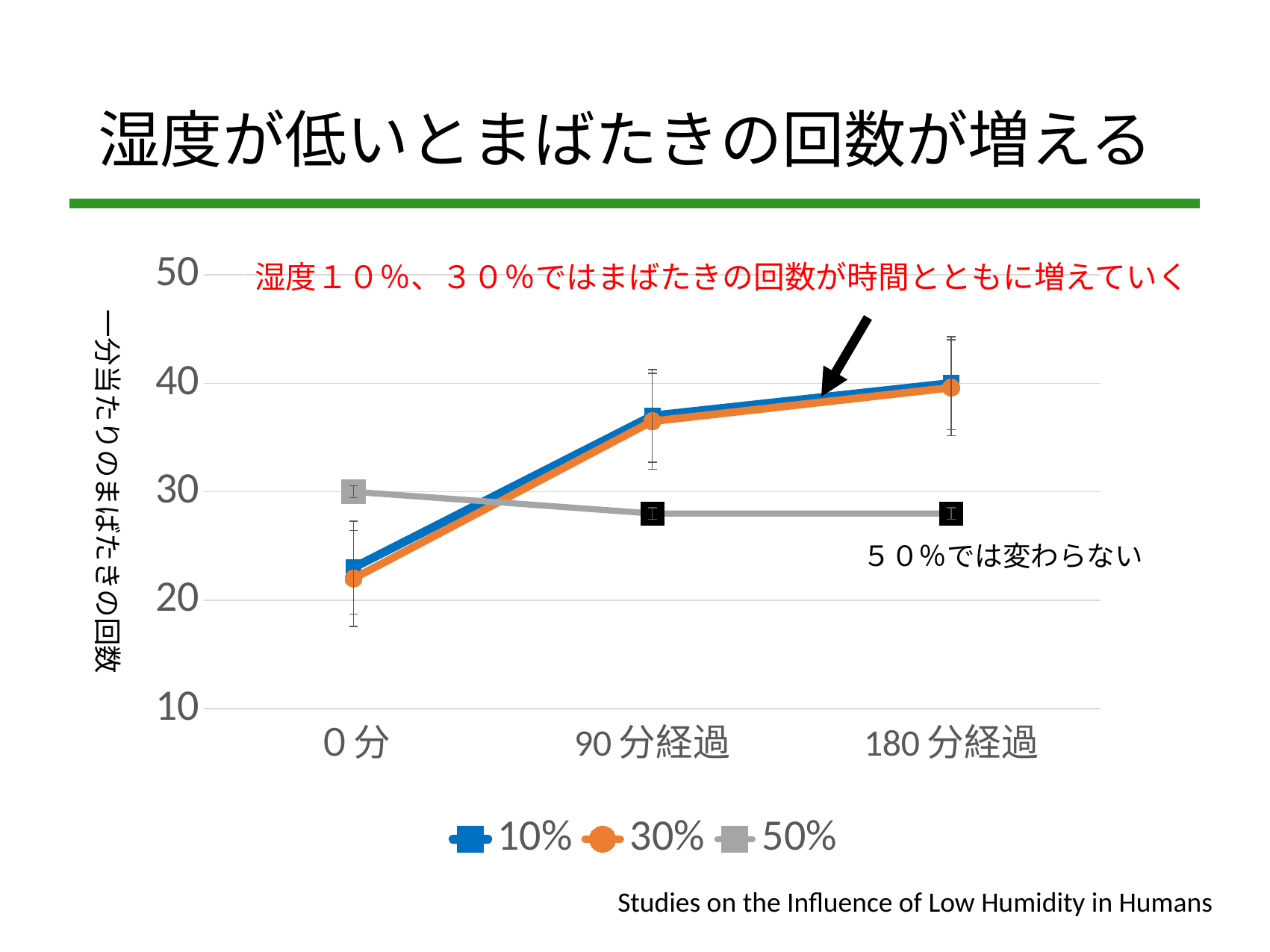
What kind of chart is shown on the slide? line chart How many series does the legend list? 3 What is the title of the slide? 湿度が低いとまばたきの回数が増える At 0分, which series has the higher value, 10% or 50%? 50% How many points are there along the x axis? 3 At 180分経過, which series has the higher value, 10% or 50%? 10% Is the value for the 50% series at 180分経過 greater or less than 30? less What are the series names listed in the legend? 10%, 30%, 50% Is the value for the 30% series at 90分経過 greater or less than 30? greater Is the value for the 10% series at 0分 greater or less than 30? less Do the values for the 10% series rise or fall from 0分 to 180分経過? rise